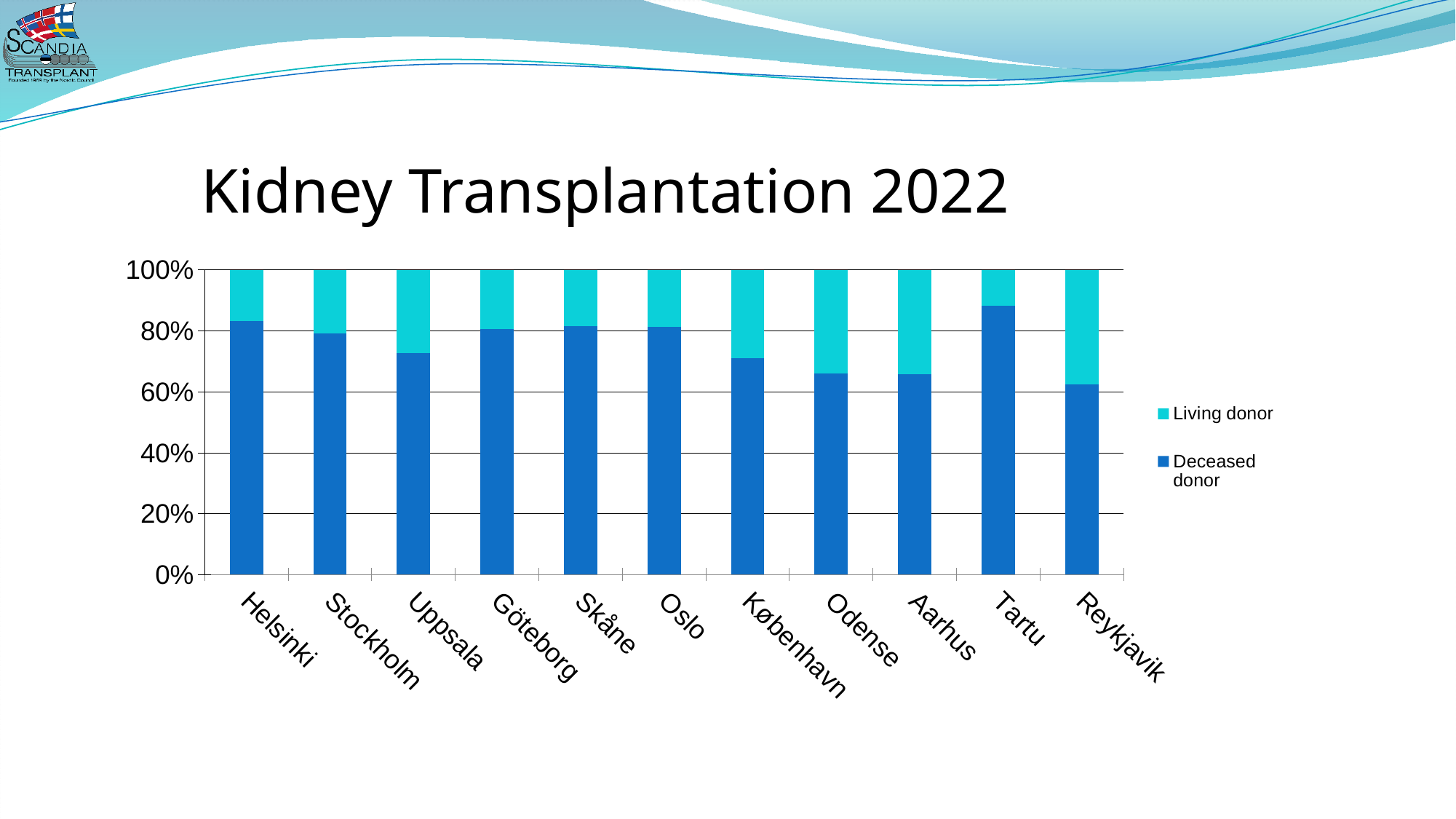
Which centre has the lowest share of deceased donor kidney transplants? Reykjavik What kind of chart is shown on the slide? Stacked bar chart What is the title of the chart? Kidney Transplantation 2022 Which centre has the highest share of deceased donor kidney transplants? Tartu How many centres (categories) are shown on the x axis? 11 Which centre has the largest share of living donor kidney transplants? Reykjavik Is the deceased donor share for Uppsala greater or less than 80%? less How many series does the legend list? 2 Is the deceased donor share for Reykjavik greater or less than 80%? less Is the deceased donor share for Tartu greater or less than 80%? greater What does each stacked bar total? 100% Which has the larger deceased donor share, Helsinki or Uppsala? Helsinki